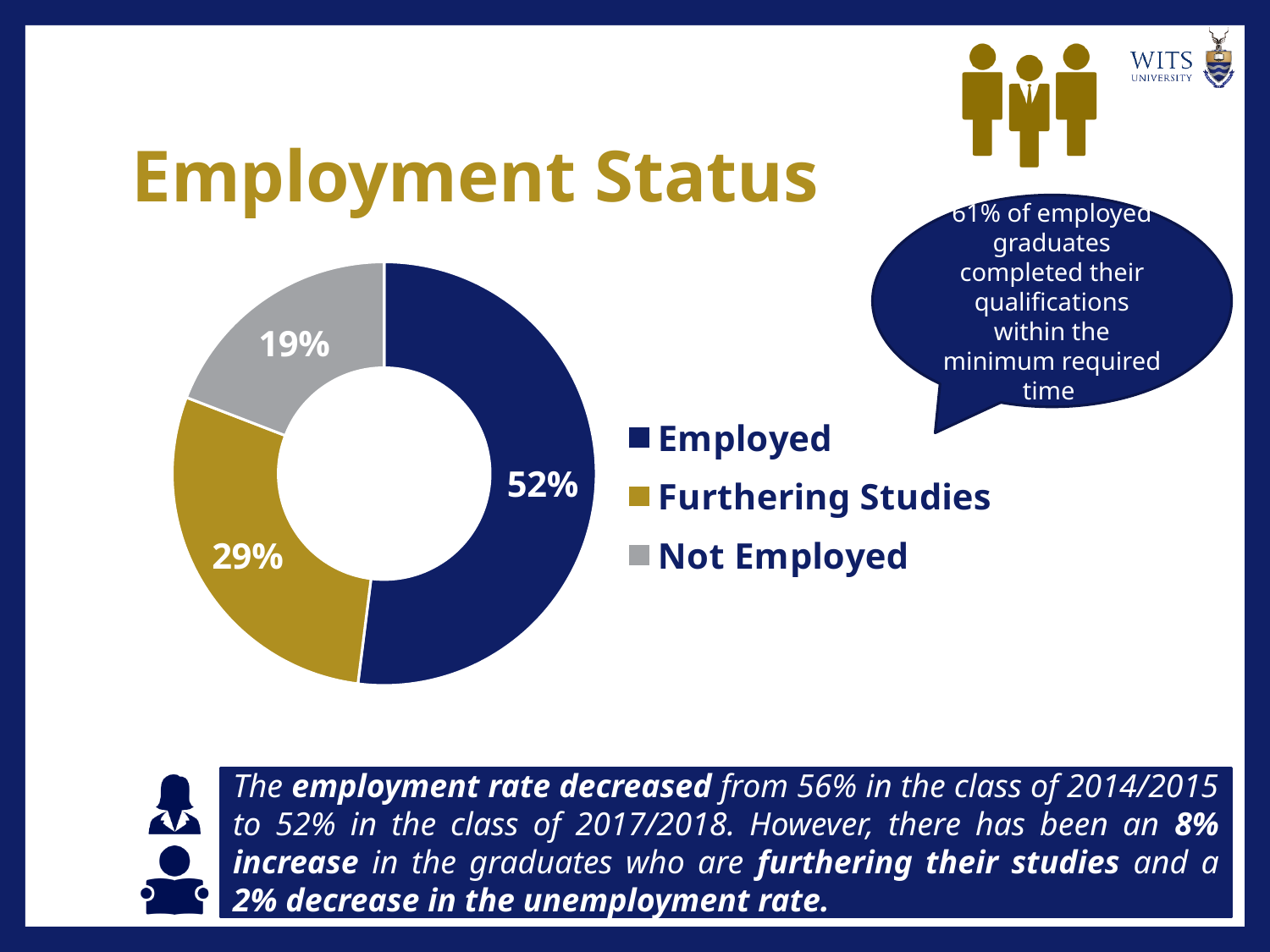
What percentage of graduates are Employed according to the chart? 52% Which category has the largest share of the chart? Employed What is the difference in percentage points between Furthering Studies and Not Employed? 10 How many categories does the chart show? 3 Which is larger: the share for Furthering Studies or the share for Not Employed? Furthering Studies What percentage of graduates are Not Employed? 19% What is the difference in percentage points between Employed and Furthering Studies? 23 Which colour represents the Not Employed category in the chart? Grey What percentage of graduates are Furthering Studies? 29% Which category has the smallest share of the chart? Not Employed What kind of chart is shown on the slide? Doughnut (pie) chart What is the title of the slide containing the chart? Employment Status